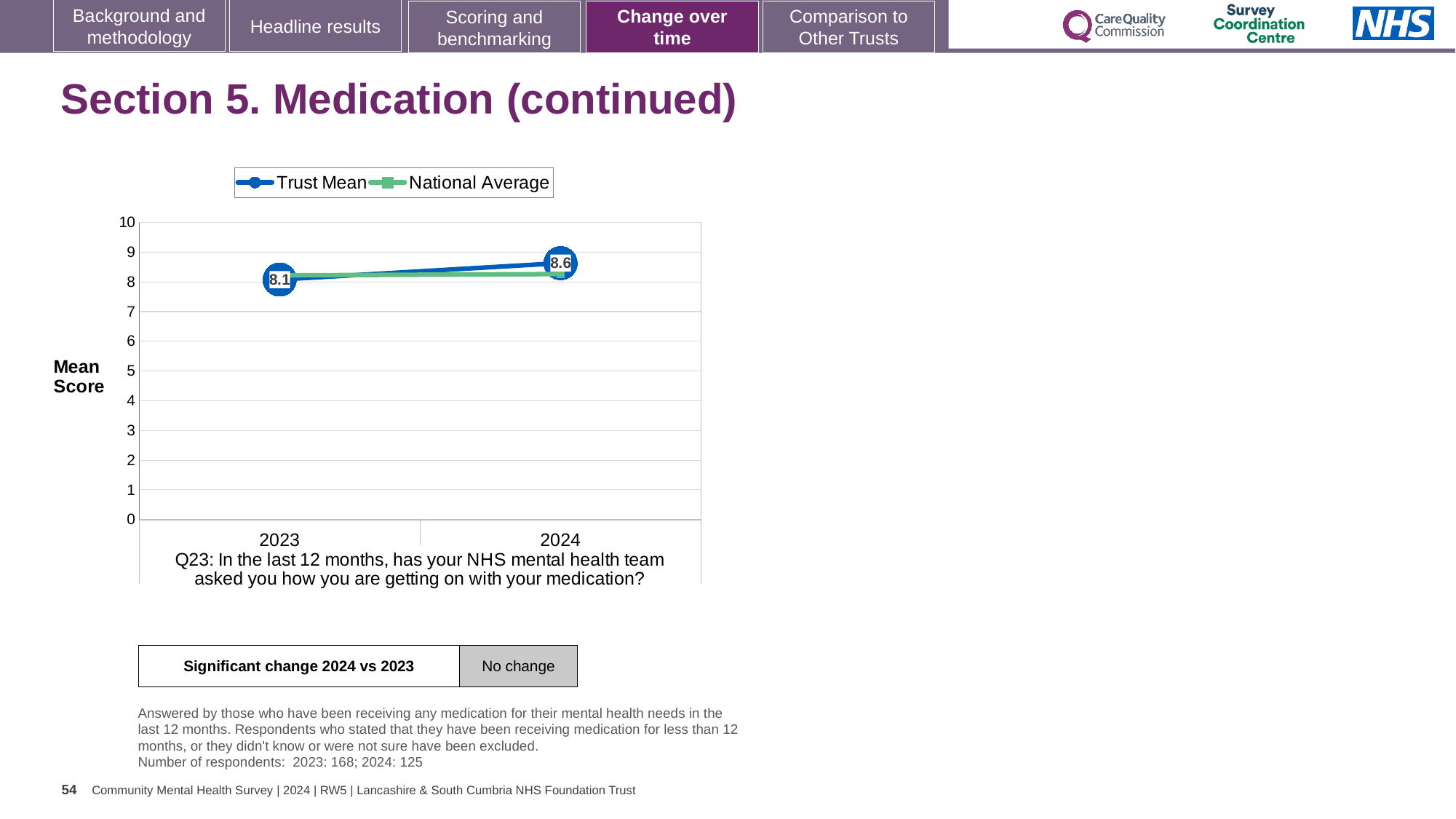
In 2024, which is larger, the Trust Mean or the National Average? Trust Mean How many years are plotted on the x axis? 2 How many series does the legend list? 2 What is the label on the y axis of the chart? Mean Score Does the Trust Mean rise or fall from 2023 to 2024? rise Which year has the lowest Trust Mean? 2023 What is the Trust Mean value for 2024? 8.6 What kind of chart is shown on the slide? line chart Is the National Average value for 2024 greater or less than 7? greater Which year has the higher Trust Mean, 2023 or 2024? 2024 What is the Trust Mean value for 2023? 8.1 By how much did the Trust Mean change from 2023 to 2024? 0.5